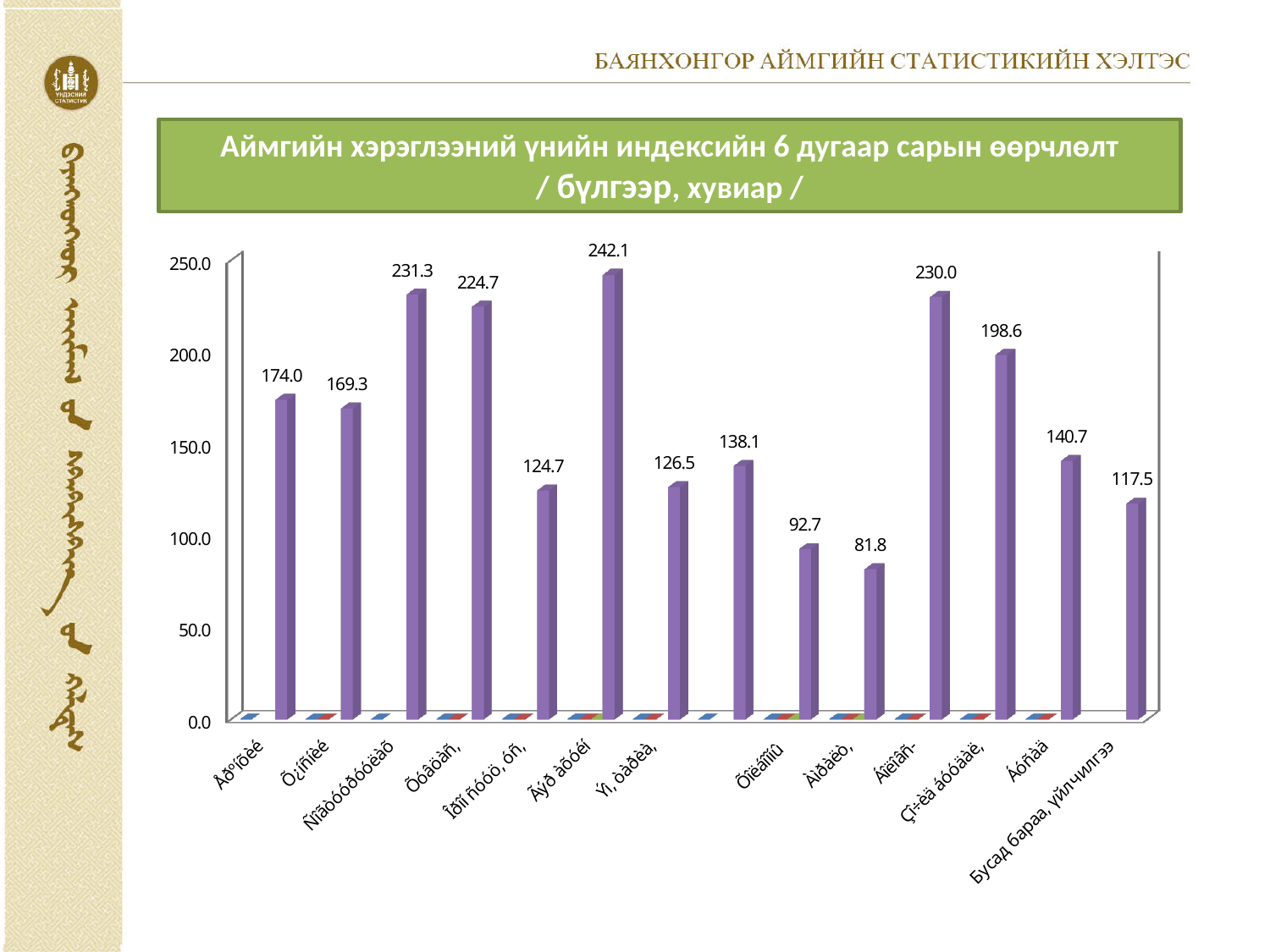
What is the highest value shown on the chart? 242.1 Is the value for Бусад бараа, үйлчилгээ greater or less than 100.0? greater What is the difference between the highest value (242.1) and the lowest value (81.8) on the chart? 160.3 What is the value of the second bar from the left? 169.3 How many bars are plotted on the chart? 14 What is the value for Бусад бараа, үйлчилгээ? 117.5 What is the title of the chart? Аймгийн хэрэглээний үнийн индексийн 6 дугаар сарын өөрчлөлт / бүлгээр, хувиар / What is the value of the first bar from the left? 174.0 What kind of chart is shown on the slide? Bar chart Which is larger, the third bar from the left or the fourth bar from the left? The third bar (231.3) What is the difference between the first bar (174.0) and the second bar (169.3)? 4.7 What is the lowest value shown on the chart? 81.8